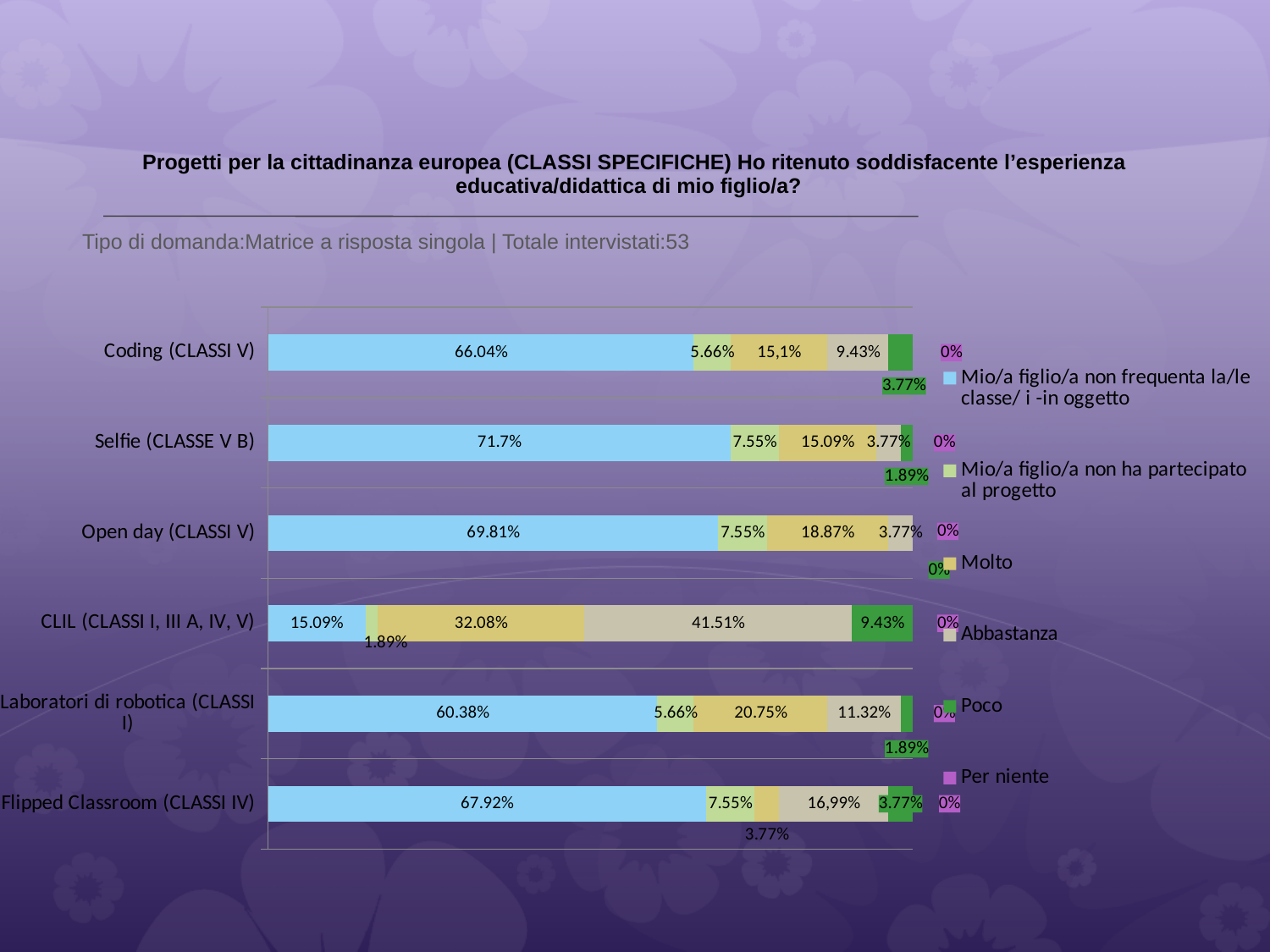
What is the total number of respondents stated on the slide? 53 What is the value of 'Mio/a figlio/a non frequenta la/le classe/ i -in oggetto' for Selfie (CLASSE V B)? 71.7% What is the 'Abbastanza' value for CLIL (CLASSI I, III A, IV, V)? 41.51% What is the 'Poco' value for Coding (CLASSI V)? 3.77% Which is larger: the 'Molto' value for CLIL (CLASSI I, III A, IV, V) or the 'Molto' value for Coding (CLASSI V)? CLIL (CLASSI I, III A, IV, V) What kind of chart is shown on the slide? Stacked bar chart How many categories (projects) are shown on the chart? 6 How many series does the legend list? 6 Which category has the lowest 'Mio/a figlio/a non frequenta la/le classe/ i -in oggetto' value? CLIL (CLASSI I, III A, IV, V) What is the 'Molto' value for Open day (CLASSI V)? 18.87% Which category has the highest 'Mio/a figlio/a non frequenta la/le classe/ i -in oggetto' value? Selfie (CLASSE V B) What is the 'Molto' value for Laboratori di robotica (CLASSI I)? 20.75%